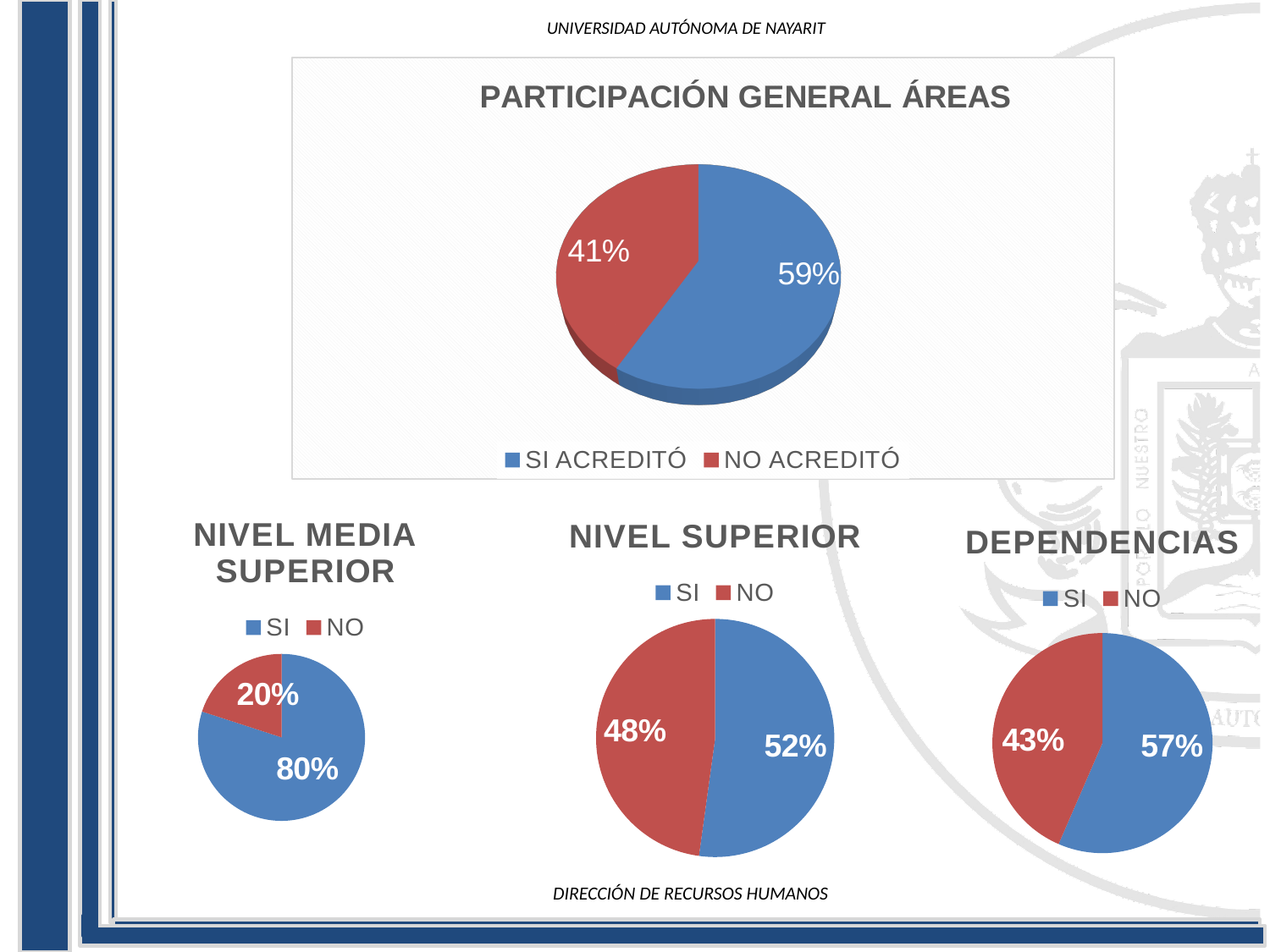
In the 'DEPENDENCIAS' chart, what share of the pie is 'SI'? 57% In the 'DEPENDENCIAS' chart, what is the difference between the 'SI' and 'NO' shares? 14% In the 'NIVEL MEDIA SUPERIOR' chart, what share of the pie is 'SI'? 80% How many entries does the legend of the 'PARTICIPACIÓN GENERAL ÁREAS' chart list? 2 How many pie charts are shown on the slide? 4 In the 'NIVEL SUPERIOR' chart, which slice is larger, 'SI' or 'NO'? SI In the 'PARTICIPACIÓN GENERAL ÁREAS' chart, what share of the pie is 'SI ACREDITÓ'? 59% What kind of chart is 'PARTICIPACIÓN GENERAL ÁREAS'? Pie chart In the 'NIVEL MEDIA SUPERIOR' chart, what is the difference between the 'SI' and 'NO' shares? 60%